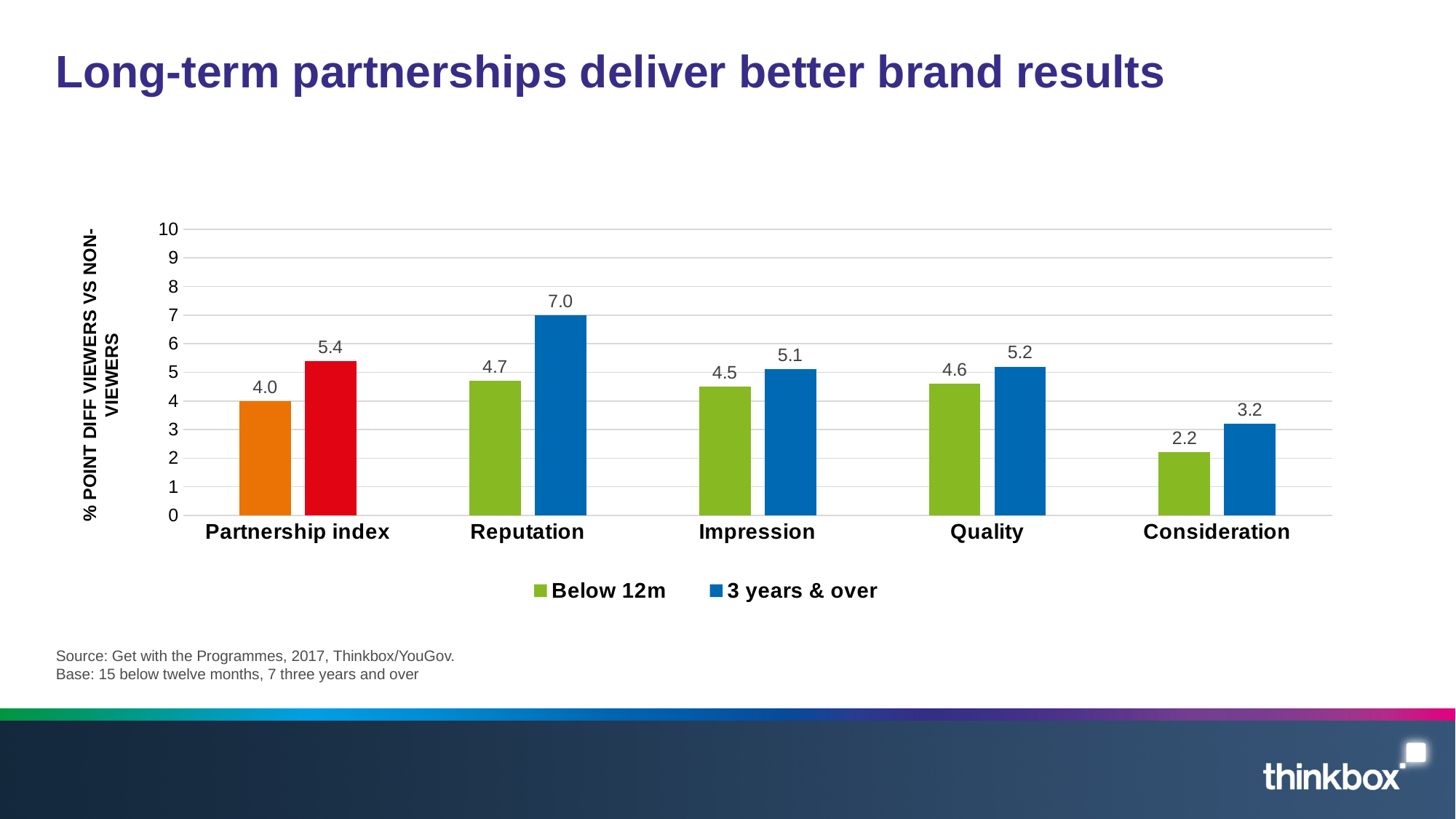
What is the value for '3 years & over' in the Reputation category? 7.0 How many categories are shown on the x axis? 5 Which category has the highest value for the '3 years & over' series? Reputation Which category has the lowest value for the 'Below 12m' series? Consideration Is the '3 years & over' value for Impression greater or less than 4? greater Which is larger for Quality: the 'Below 12m' value or the '3 years & over' value? 3 years & over What is the difference between the '3 years & over' and 'Below 12m' values for Partnership index? 1.4 What is the value for 'Below 12m' in the Consideration category? 2.2 How many series does the legend list? 2 What is the difference between the '3 years & over' and 'Below 12m' values for Reputation? 2.3 What is the value for 'Below 12m' in the Partnership index category? 4.0 What kind of chart is shown on the slide? Bar chart